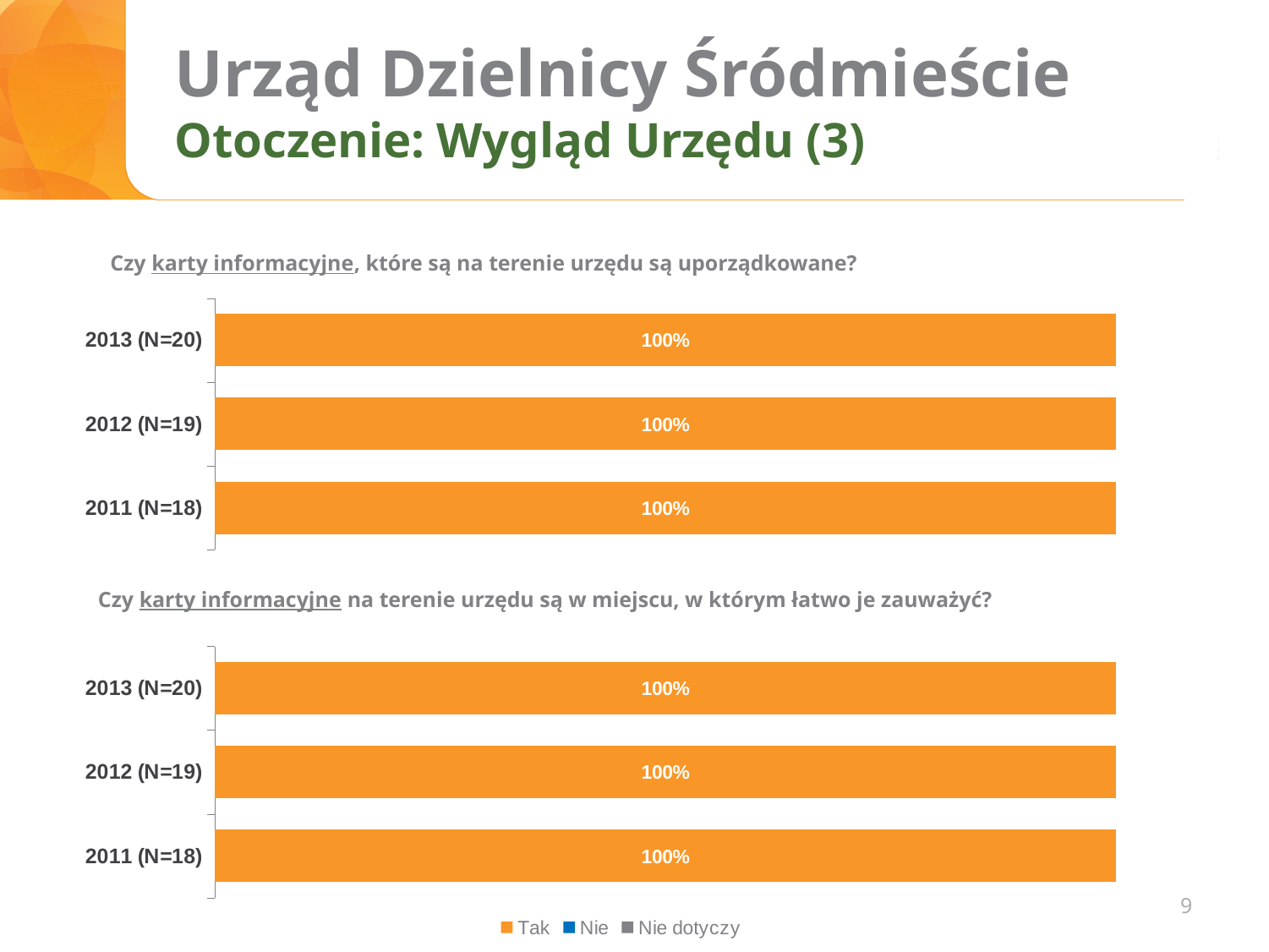
In the top chart, what is the difference between the values for 2013 (N=20) and 2011 (N=18)? 0% In the top chart ("Czy karty informacyjne, które są na terenie urzędu są uporządkowane?"), what is the value for 2011 (N=18)? 100% In the bottom chart ("Czy karty informacyjne na terenie urzędu są w miejscu, w którym łatwo je zauważyć?"), what is the value for 2013 (N=20)? 100% In the bottom chart ("Czy karty informacyjne na terenie urzędu są w miejscu, w którym łatwo je zauważyć?"), what is the value for 2012 (N=19)? 100% In the bottom chart, what is the difference between the values for 2012 (N=19) and 2011 (N=18)? 0% What kind of chart is the top chart? Bar chart How many series does the legend at the bottom of the slide list? 3 Which series do the orange bars in the bottom chart represent? Tak How many categories (years) are shown in the bottom chart? 3 In the top chart ("Czy karty informacyjne, które są na terenie urzędu są uporządkowane?"), what is the value for 2013 (N=20)? 100% How many categories (years) are shown in the top chart? 3 In the top chart, do the values change between 2011 (N=18) and 2013 (N=20)? No, they stay at 100%